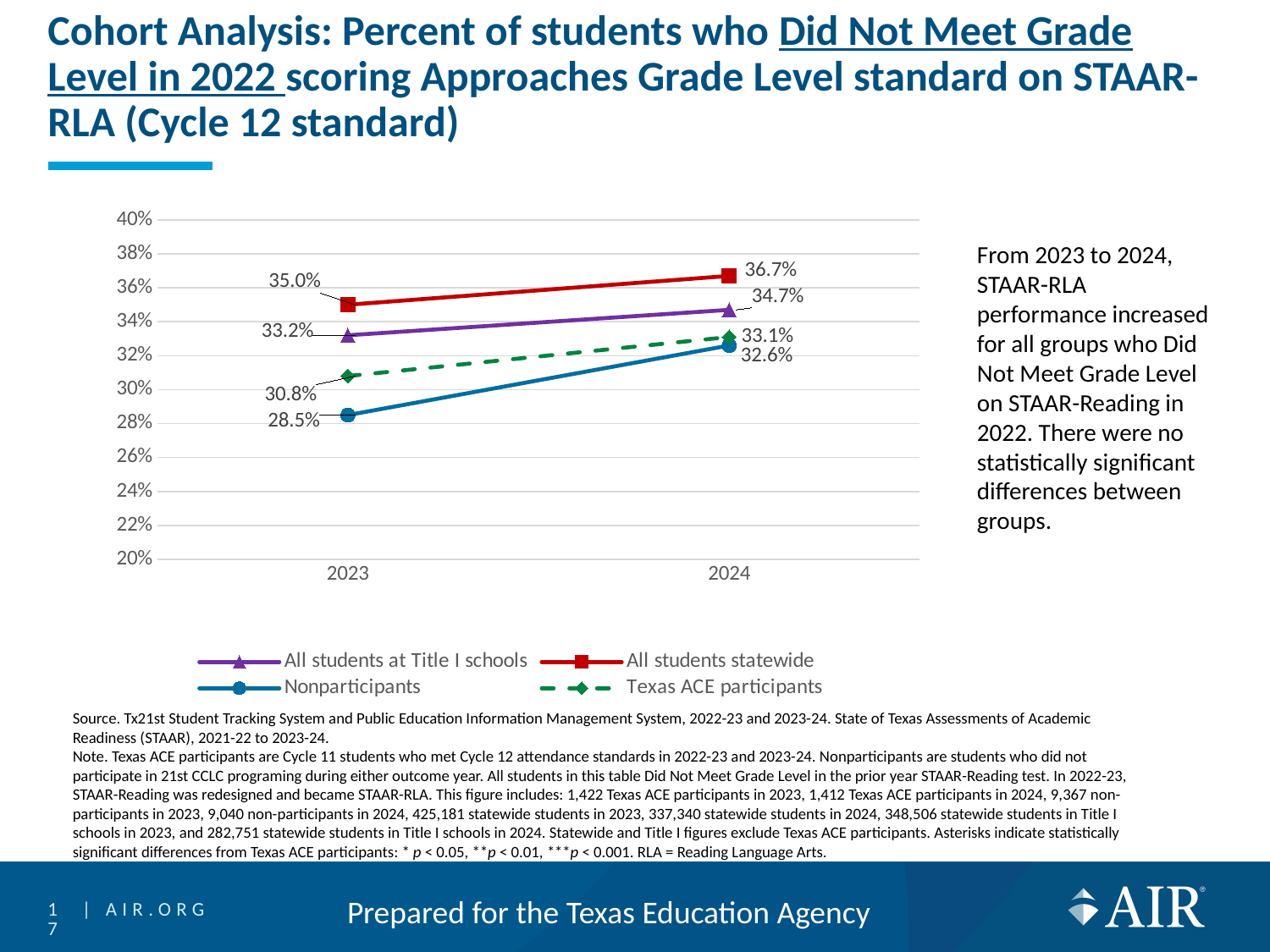
What is the value for All students at Title I schools in 2023? 33.2% Which series is drawn with a dashed line? Texas ACE participants How many years are shown on the x axis? 2 What is the value for Nonparticipants in 2023? 28.5% Which series has the lowest value in 2024? Nonparticipants What is the value for Texas ACE participants in 2024? 33.1% What is the difference between the Nonparticipants values in 2024 and 2023? 4.1% How many series does the legend list? 4 Does the value for Texas ACE participants rise or fall from 2023 to 2024? rise What is the value for All students statewide in 2024? 36.7% Which series has the highest value in 2023? All students statewide What kind of chart is shown on the slide? line chart